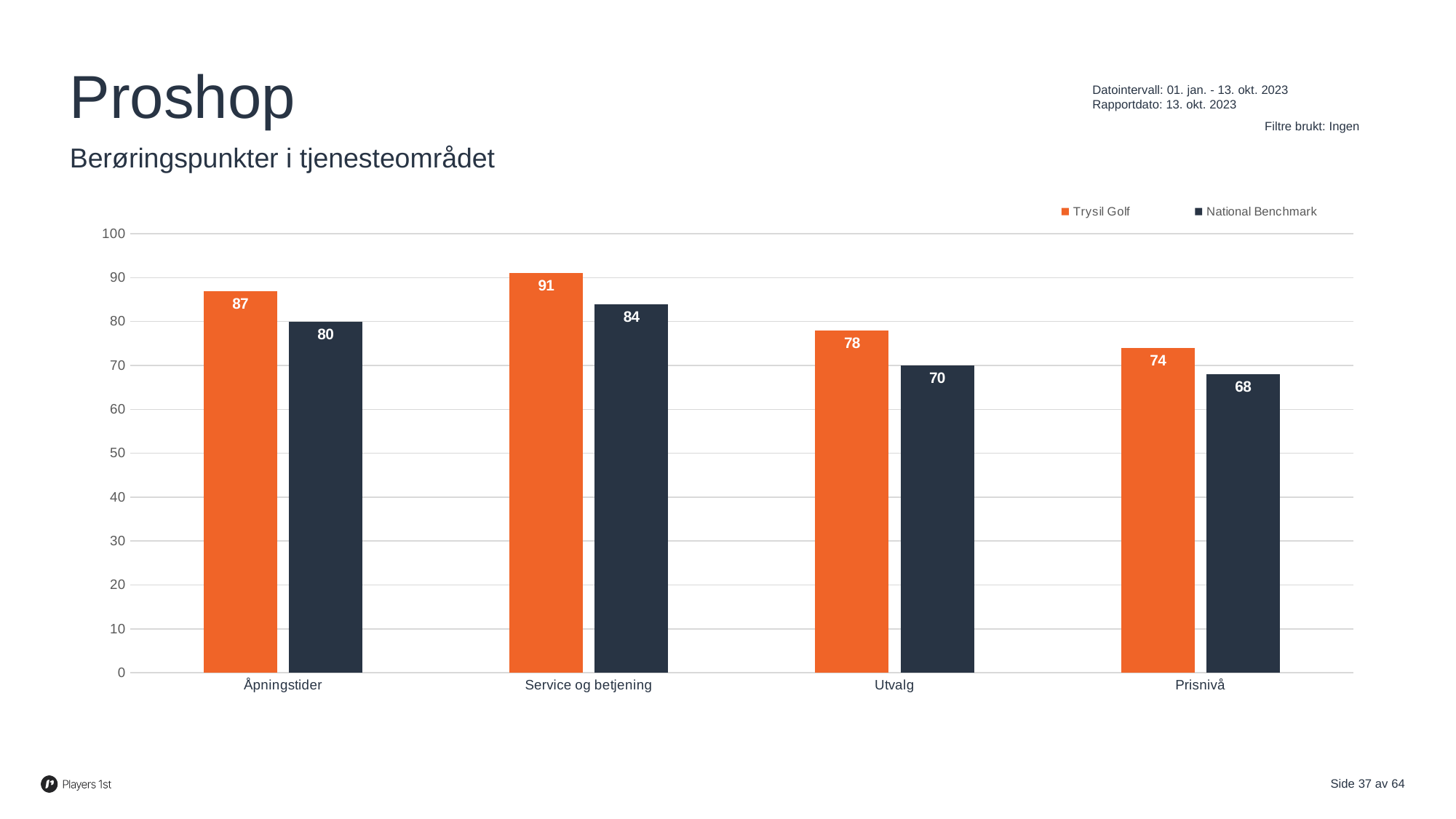
What kind of chart is shown on the slide? Bar chart Which is larger for Åpningstider: Trysil Golf or National Benchmark? Trysil Golf How many categories are shown on the x axis? 4 What is the Trysil Golf value for Utvalg? 78 What is the National Benchmark value for Prisnivå? 68 Which category has the lowest National Benchmark value? Prisnivå What is the difference between the Trysil Golf and National Benchmark values for Utvalg? 8 What is the Trysil Golf value for Service og betjening? 91 Which colour represents National Benchmark in the chart? Dark navy What is the difference between the Trysil Golf values for Service og betjening and Prisnivå? 17 Which category has the highest Trysil Golf value? Service og betjening How many series does the legend list? 2